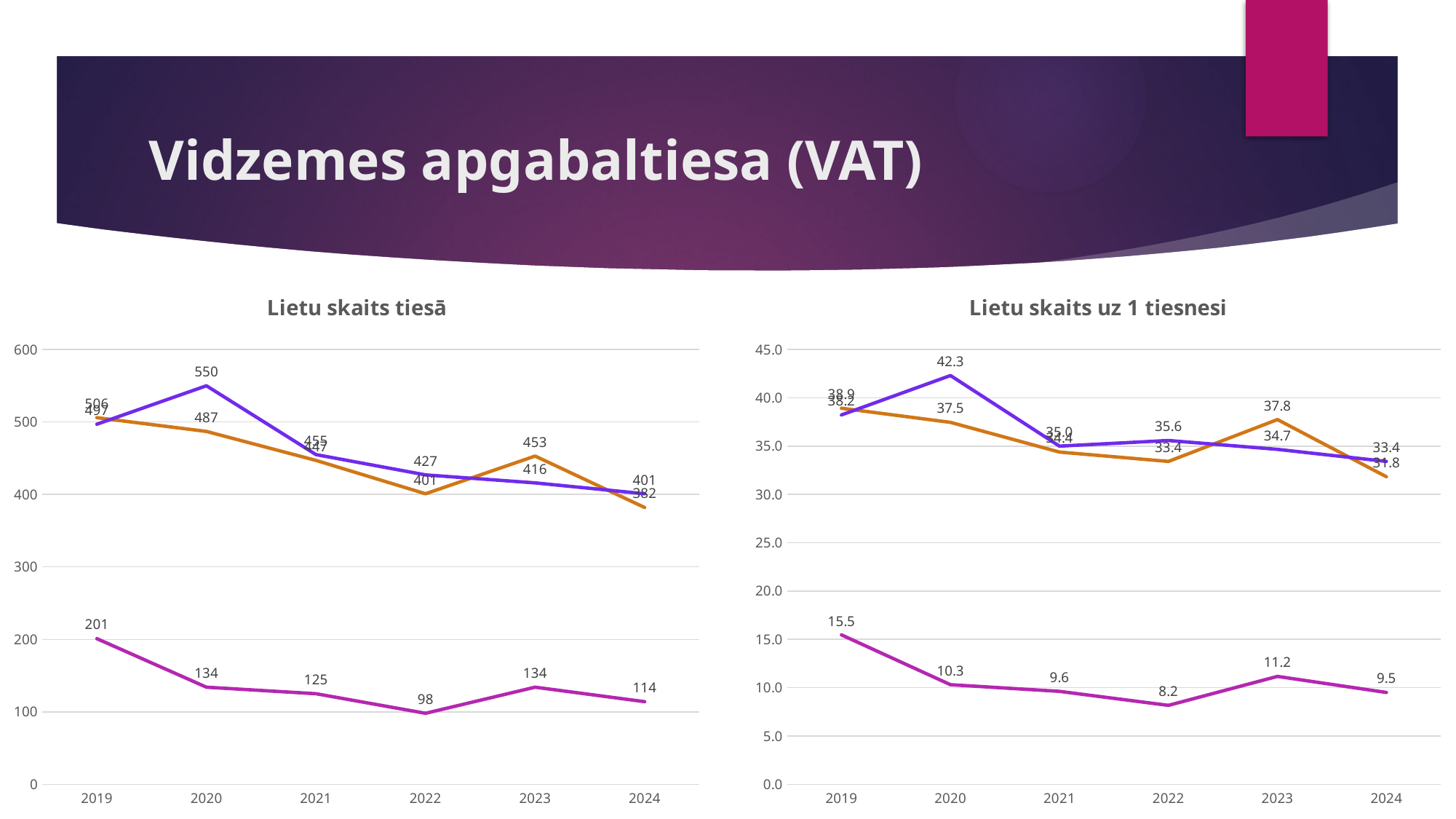
What kind of chart is "Lietu skaits uz 1 tiesnesi"? line chart In the chart titled "Lietu skaits tiesā", in which year does the magenta line reach its lowest value? 2022 In the chart titled "Lietu skaits tiesā", what is the value of the purple line in 2020? 550 In the chart titled "Lietu skaits tiesā", what is the difference between the purple line's value in 2020 and its value in 2021? 95 In the chart titled "Lietu skaits uz 1 tiesnesi", which is larger in 2023: the orange line or the purple line? the orange line In the chart titled "Lietu skaits uz 1 tiesnesi", what is the value of the purple line in 2020? 42.3 In the chart titled "Lietu skaits uz 1 tiesnesi", what is the value of the magenta line in 2022? 8.2 In the chart titled "Lietu skaits uz 1 tiesnesi", does the magenta line generally rise or fall from 2019 to 2024? fall In the chart titled "Lietu skaits tiesā", how many years are shown on the x axis? 6 In the chart titled "Lietu skaits tiesā", what is the value of the orange line in 2023? 453 In the chart titled "Lietu skaits uz 1 tiesnesi", what is the difference between the magenta line's values in 2019 and 2020? 5.2 In the chart titled "Lietu skaits tiesā", what is the value of the magenta line in 2019? 201